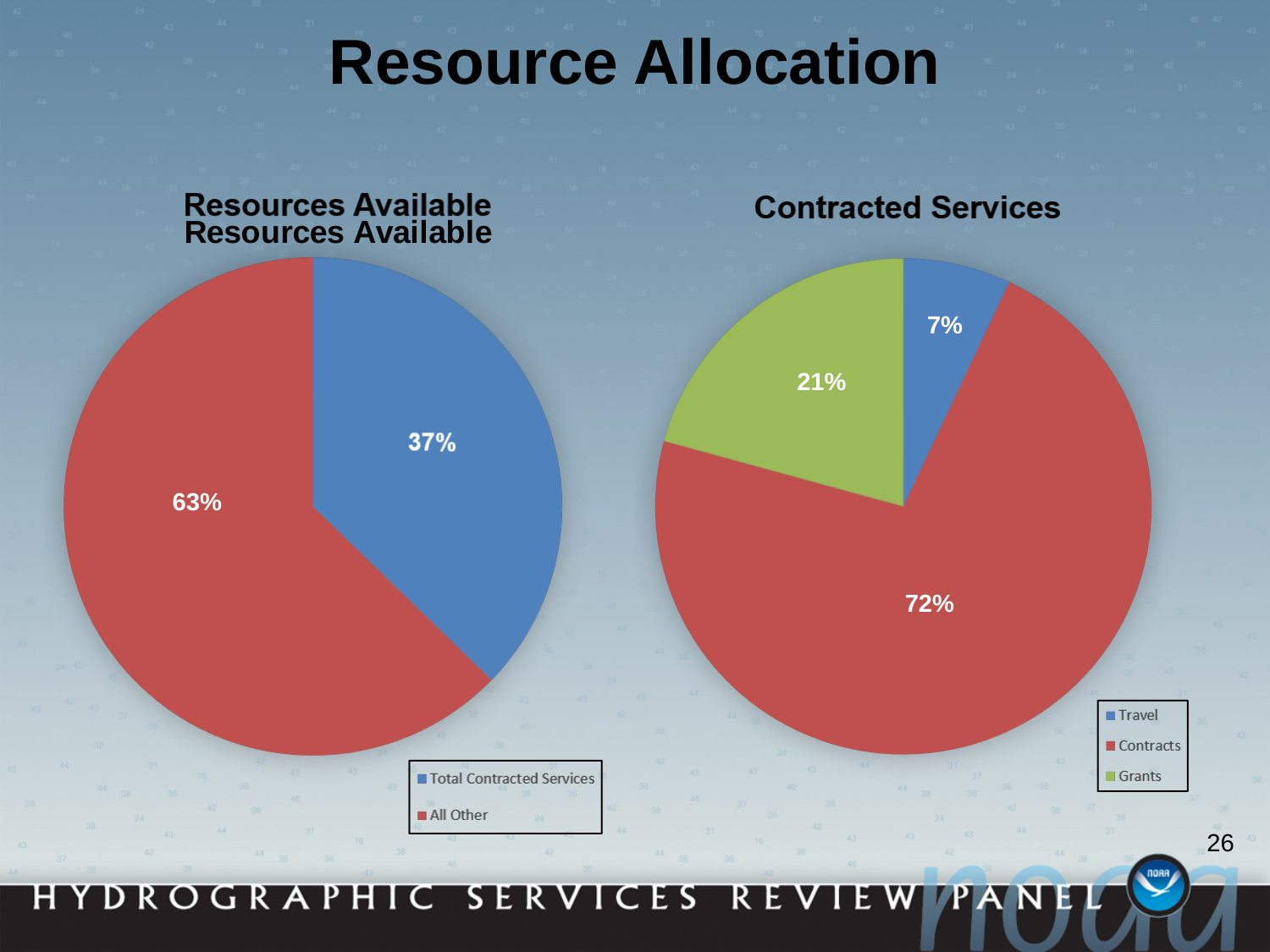
In the Contracted Services chart, what share is Travel? 7% How many slices does the Contracted Services chart have? 3 In the Resources Available chart, what share is All Other? 63% In the Contracted Services chart, which category has the smallest slice? Travel In the Resources Available chart, what share is Total Contracted Services? 37% In the Contracted Services chart, which is larger, Grants or Travel? Grants In the Contracted Services chart, what share is Contracts? 72% What kind of chart is the Resources Available chart? Pie chart In the Contracted Services chart, what share is Grants? 21% How many entries does the legend of the Contracted Services chart list? 3 In the Resources Available chart, what is the difference in percentage points between All Other and Total Contracted Services? 26 In the Contracted Services chart, which category has the largest slice? Contracts